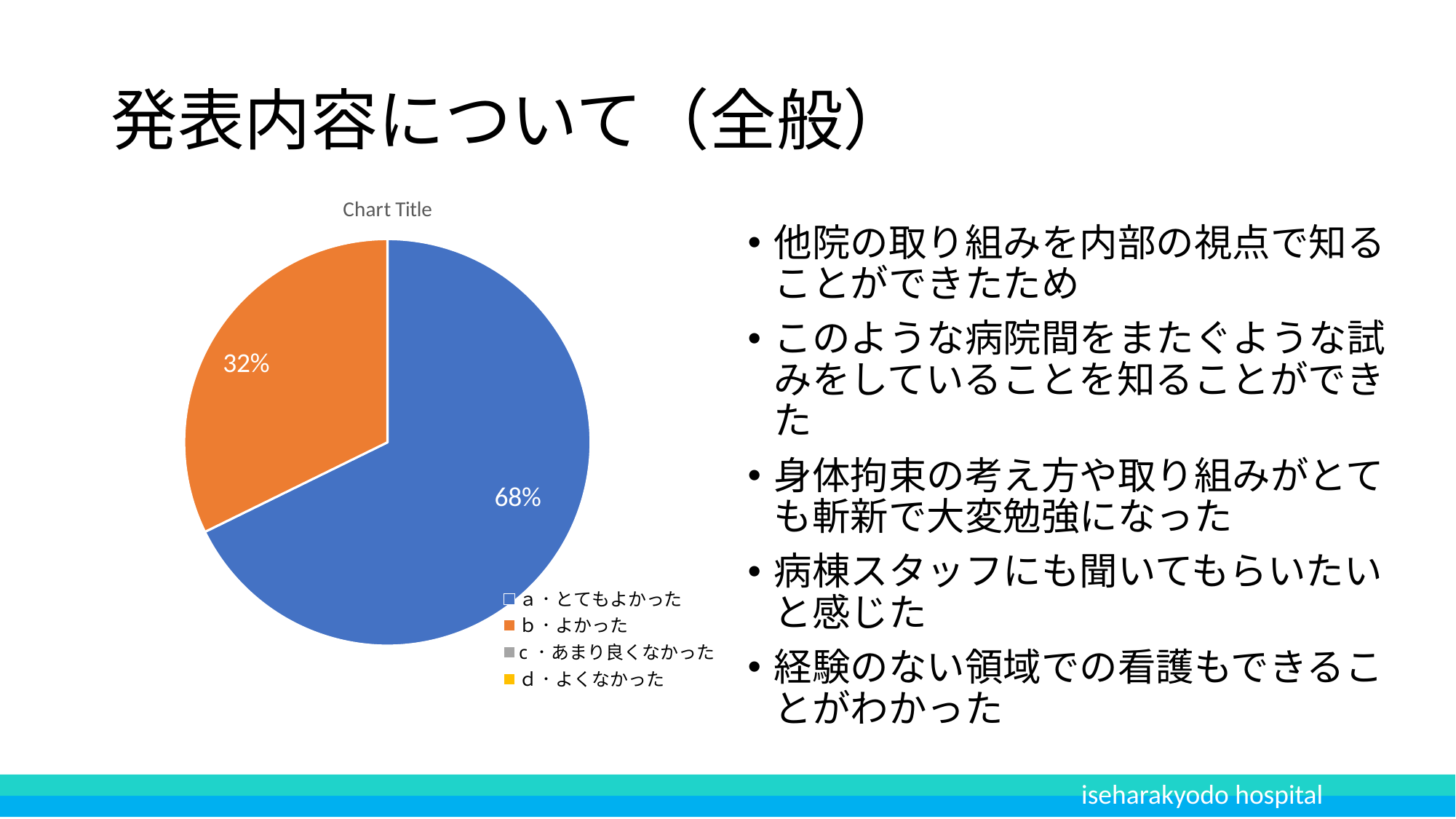
What share of the pie does the slice for a・とてもよかった represent? 68% What share of the pie does the slice for b・よかった represent? 32% What is the title printed above the pie chart? Chart Title Which of the two visible slices is larger, a・とてもよかった or b・よかった? a・とてもよかった What is the difference in percentage points between the a・とてもよかった slice and the b・よかった slice? 36 Which category has the largest slice of the pie? a・とてもよかった How many slices with a printed percentage label are visible in the pie chart? 2 How many entries does the legend of the pie chart list? 4 What is the combined share of the a・とてもよかった and b・よかった slices? 100% What colour is the slice for b・よかった? orange What kind of chart is shown on the slide? pie chart